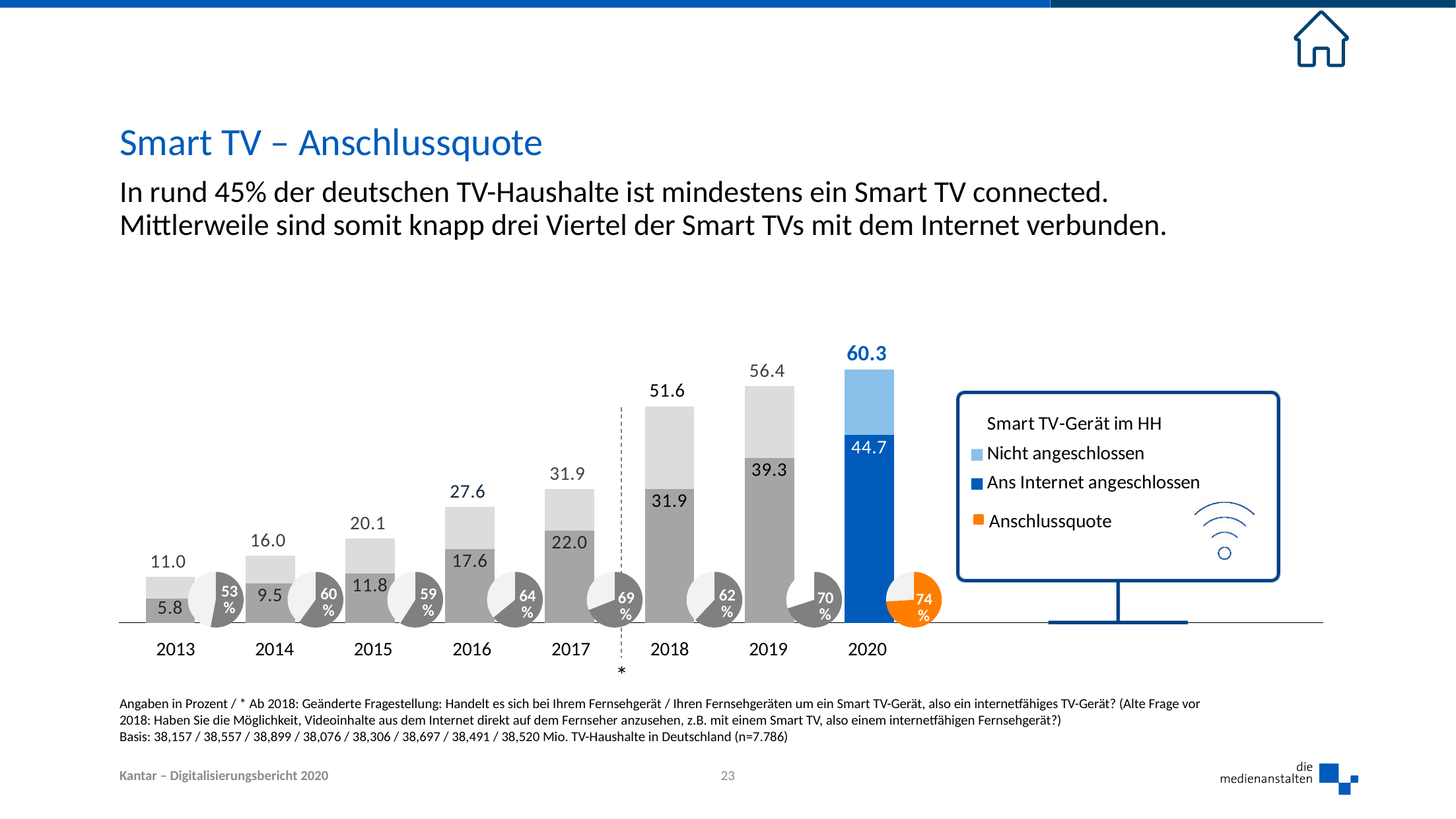
What Anschlussquote percentage is shown in the small pie for 2013? 53% Which is larger: the "Ans Internet angeschlossen" value in 2018 or in 2017? 2018 How many entries does the legend list? 3 What kind of chart is used to show the Smart TV-Gerät im HH values? Stacked bar chart What is the value for "Ans Internet angeschlossen" in 2019? 39.3 Which year has the lowest value for "Ans Internet angeschlossen"? 2013 What is the total value shown above the bar for 2020? 60.3 Do the total values for Smart TV-Gerät im HH rise or fall from 2013 to 2020? Rise How many years are shown on the x axis of the chart? 8 What is the difference between the total values for 2018 and 2017? 19.7 What is the value for "Ans Internet angeschlossen" in 2016? 17.6 Which year has the highest total value for Smart TV-Gerät im HH? 2020